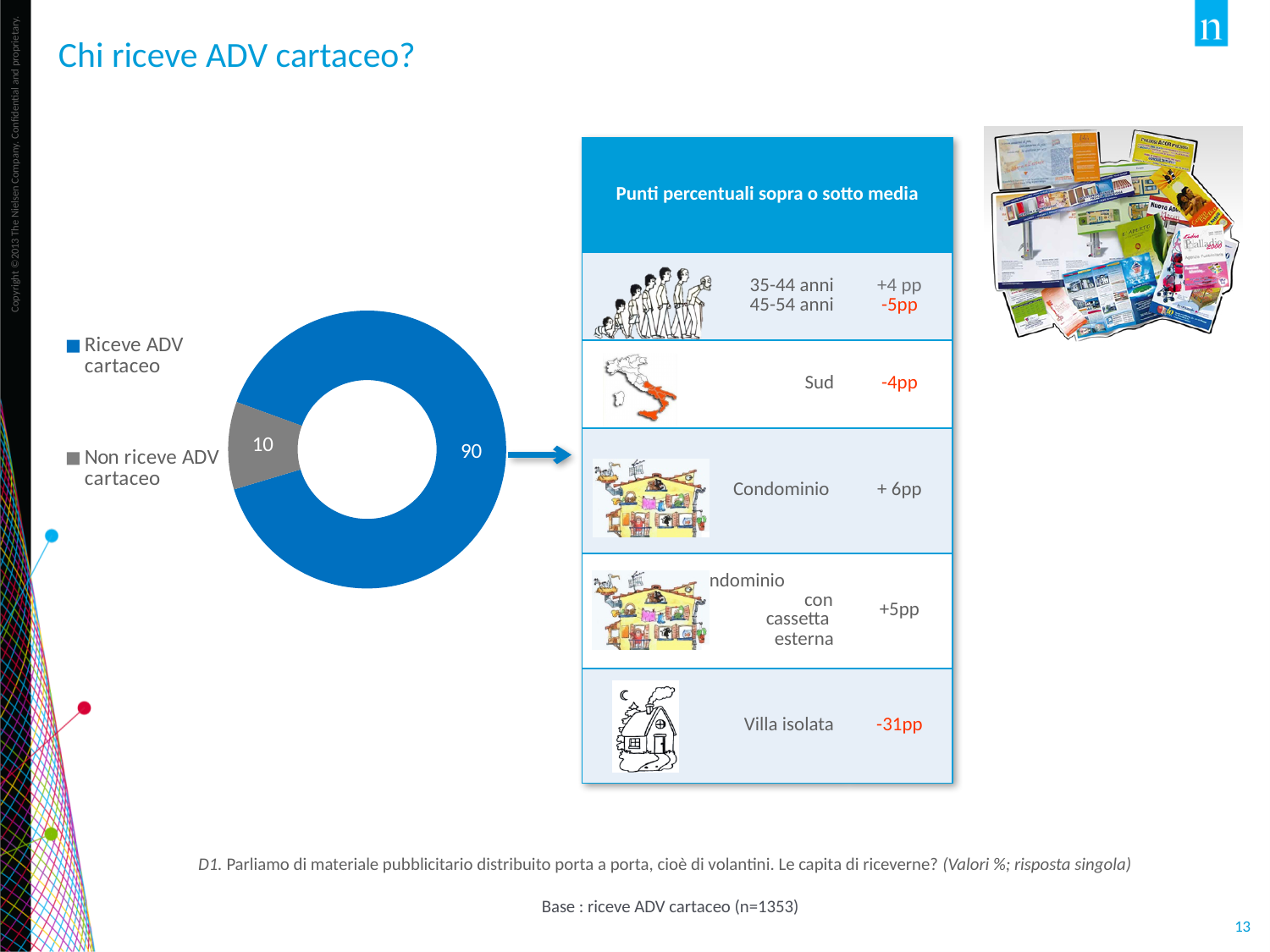
What colour is the 'Non riceve ADV cartaceo' slice in the doughnut chart? Grey What is the total of the two values shown in the doughnut chart? 100 What is the difference between the 'Riceve ADV cartaceo' and 'Non riceve ADV cartaceo' values in the doughnut chart? 80 How many slices does the doughnut chart have? 2 Which slice of the doughnut chart is the smallest? Non riceve ADV cartaceo What value is shown for the 'Non riceve ADV cartaceo' slice in the doughnut chart? 10 In the doughnut chart, which is larger: 'Riceve ADV cartaceo' or 'Non riceve ADV cartaceo'? Riceve ADV cartaceo What value is shown for the 'Riceve ADV cartaceo' slice in the doughnut chart? 90 What kind of chart is shown on the left of the slide? Doughnut (pie) chart How many entries does the legend of the doughnut chart list? 2 Which slice of the doughnut chart is the largest? Riceve ADV cartaceo What share of the doughnut chart does the 'Riceve ADV cartaceo' slice represent? 90%